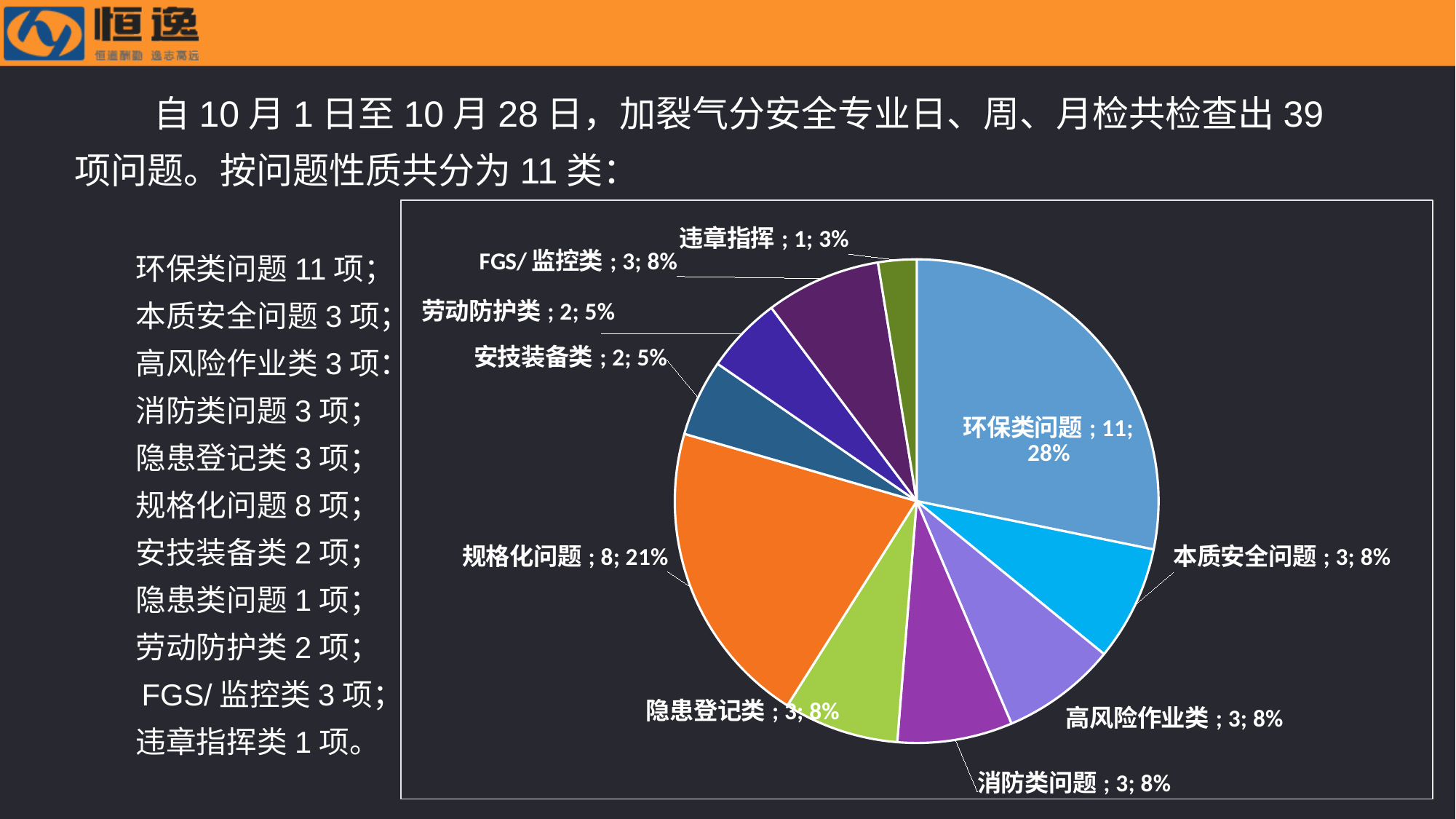
Which category has the largest slice of the pie? 环保类问题 What percentage share does the 安技装备类 slice have? 5% Which is larger, the 规格化问题 slice or the 本质安全问题 slice? 规格化问题 Which category has the smallest slice of the pie? 违章指挥 What percentage share does the 违章指挥 slice have? 3% What percentage share does the 环保类问题 slice have? 28% How many items does the 环保类问题 slice represent? 11 What kind of chart is shown on the slide? pie chart How many items does the 劳动防护类 slice represent? 2 What is the difference in item count between 环保类问题 and 规格化问题? 3 How many items does the FGS/监控类 slice represent? 3